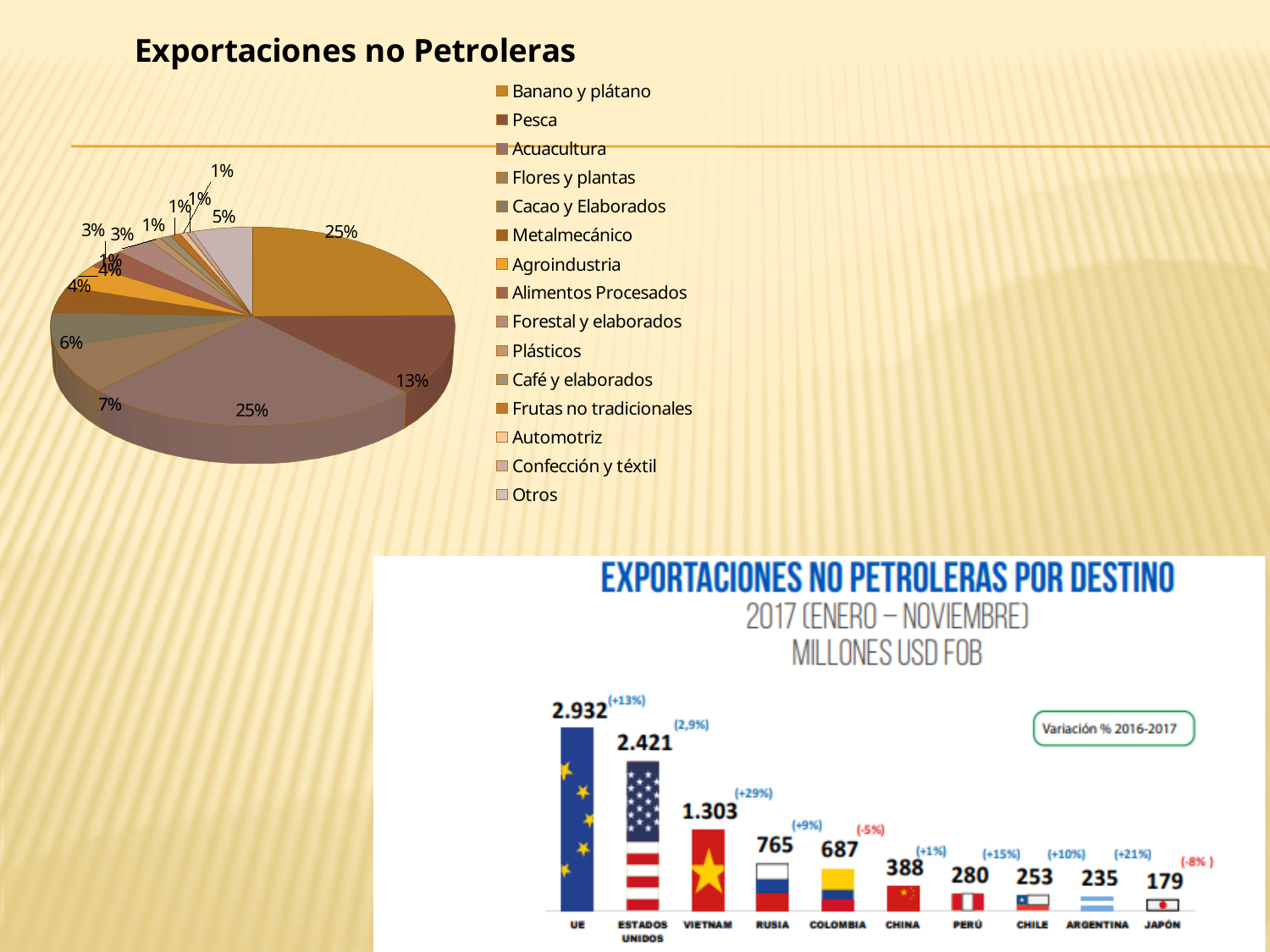
In the bar chart 'Exportaciones no Petroleras por Destino', what is the value for Colombia? 687 In the bar chart 'Exportaciones no Petroleras por Destino', which is larger, the value for Rusia or the value for China? Rusia In the pie chart 'Exportaciones no Petroleras', what share does Otros have? 5% In the bar chart 'Exportaciones no Petroleras por Destino', which destination has the highest value? UE In the pie chart 'Exportaciones no Petroleras', what share does Pesca have? 13% How many entries does the legend of the pie chart 'Exportaciones no Petroleras' list? 15 In the pie chart 'Exportaciones no Petroleras', what share does Banano y plátano have? 25% In the bar chart 'Exportaciones no Petroleras por Destino', which destination has the lowest value? Japón In the bar chart 'Exportaciones no Petroleras por Destino', what is the value for Vietnam? 1.303 What kind of chart is the chart titled 'Exportaciones no Petroleras' at the top of the slide? Pie chart In the bar chart 'Exportaciones no Petroleras por Destino', what is the difference between the values for UE and Estados Unidos? 511 How many destinations are shown in the bar chart 'Exportaciones no Petroleras por Destino'? 10